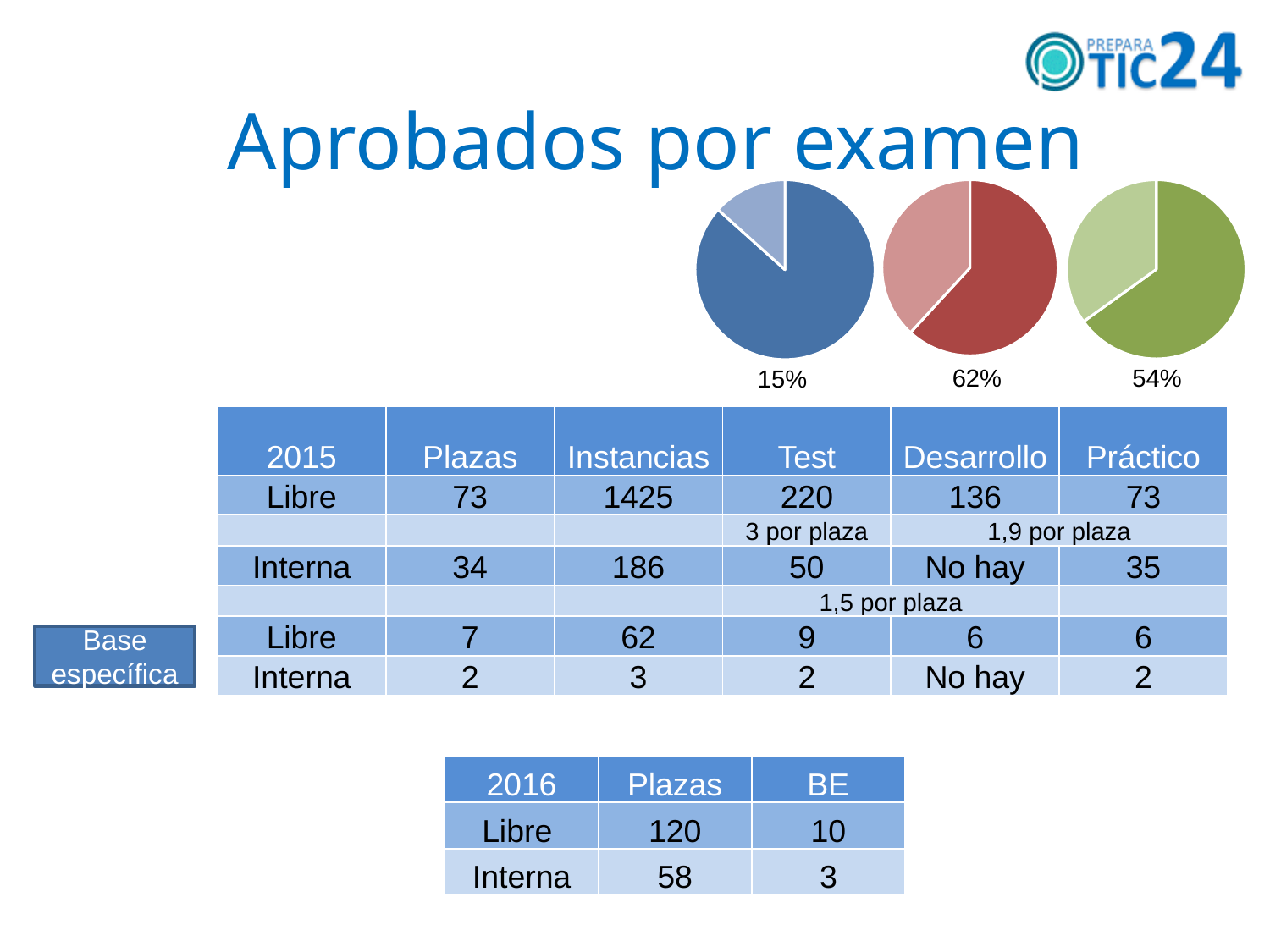
What colour is the left pie chart? Blue Is the percentage for the middle (red) pie chart larger or smaller than the percentage for the right (green) pie chart? Larger How many pie charts are on the slide? 3 Which pie chart has the highest percentage printed below it? The middle (red) pie chart, 62% What is the title of the slide above the pie charts? Aprobados por examen What percentage is printed below the middle (red) pie chart? 62% Which pie chart has the lowest percentage printed below it? The left (blue) pie chart, 15% What percentage is printed below the left (blue) pie chart? 15% What percentage is printed below the right (green) pie chart? 54% What kind of charts are shown on the slide? Pie charts What is the difference between the percentage below the middle (red) pie chart and the percentage below the left (blue) pie chart? 47% How many slices does each pie chart have? 2